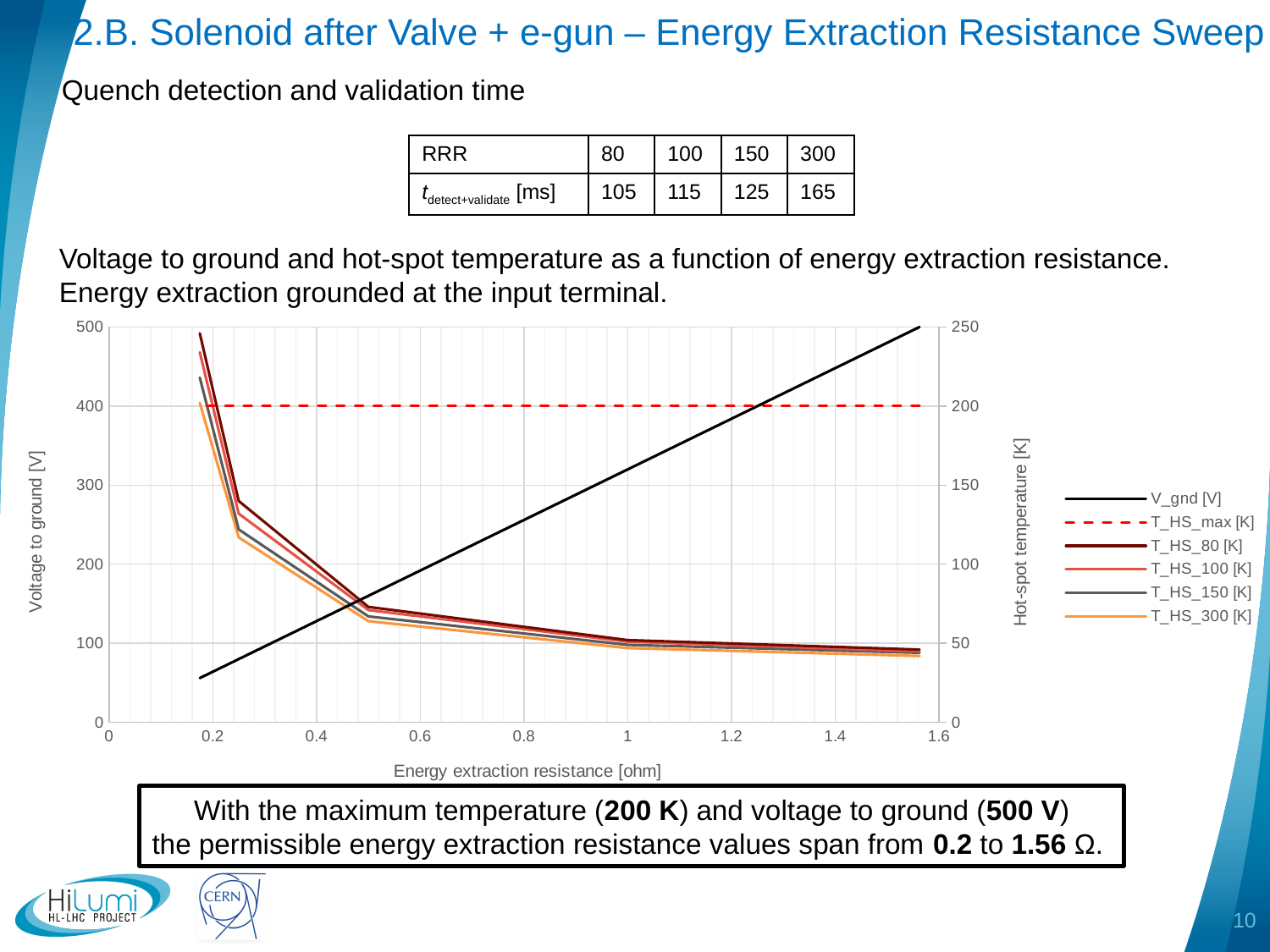
Does the T_HS_80 [K] line rise or fall as the energy extraction resistance increases? fall Is the T_HS_300 [K] value at 1.0 ohm greater or less than 100 K? less Does the V_gnd [V] line rise or fall as the energy extraction resistance increases? rise Is the T_HS_80 [K] value at 0.25 ohm greater or less than 100 K? greater How many series does the chart legend list? 6 Which of the RRR-dependent hot-spot temperature series (T_HS_80, T_HS_100, T_HS_150, T_HS_300) is highest at low resistance? T_HS_80 [K] What is the label of the chart's x axis? Energy extraction resistance [ohm] What kind of chart is shown on the slide? line chart Is the V_gnd [V] value at 1.4 ohm greater or less than 400 V? greater At 0.25 ohm, which is higher: T_HS_80 [K] or T_HS_300 [K]? T_HS_80 [K] What constant hot-spot temperature does the dashed T_HS_max [K] line sit at? 200